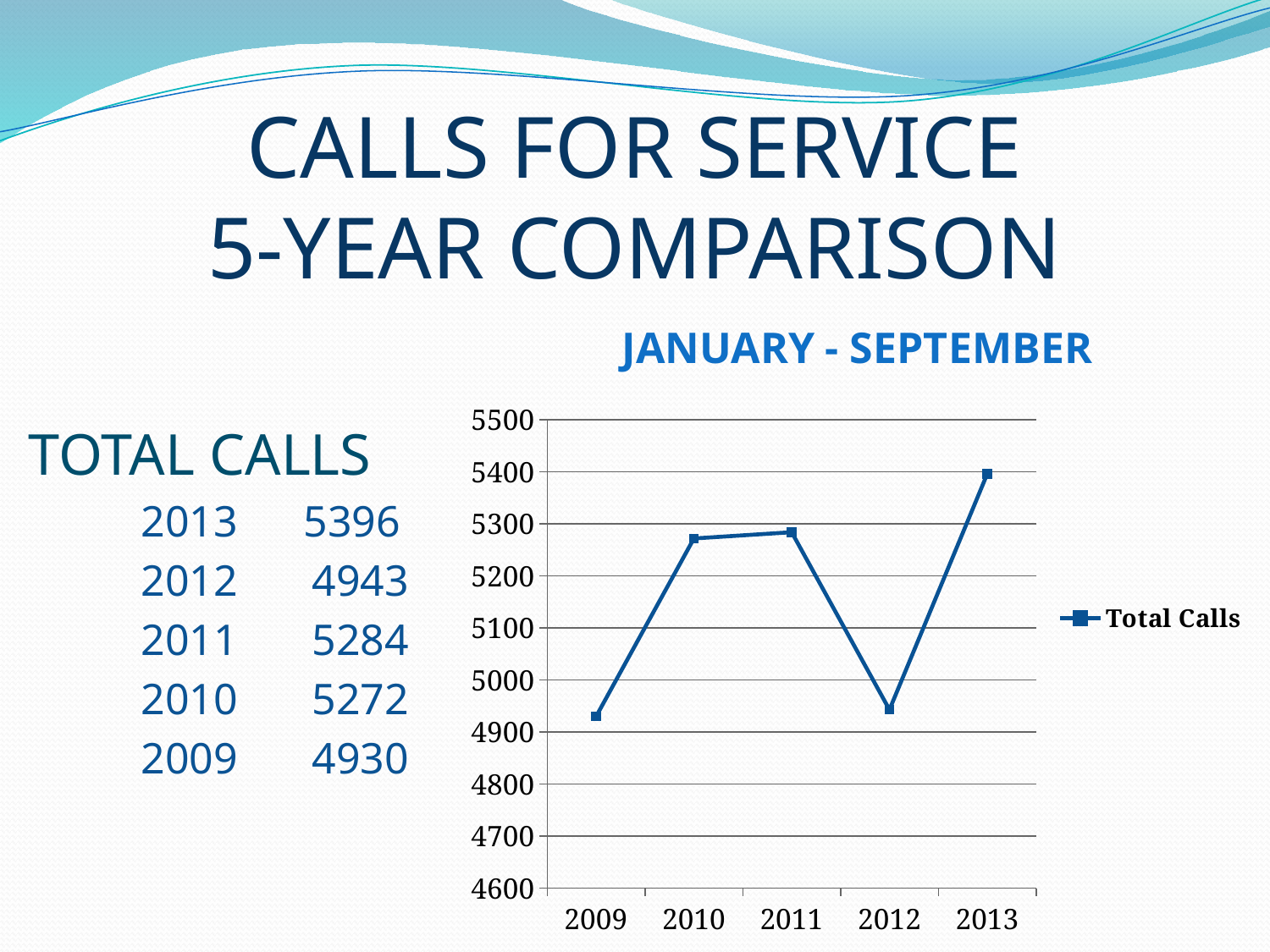
What is the value of Total Calls for 2013? 5396 What is the name of the series shown in the chart legend? Total Calls How many years are plotted on the x axis of the chart? 5 Is the value for 2012 greater or less than 5000? less What is the value of Total Calls for 2009? 4930 What is the difference in Total Calls between 2013 and 2012? 453 How many series does the chart legend list? 1 What kind of chart is shown on the slide? line chart Do Total Calls rise or fall from 2011 to 2012? fall Which year has the highest Total Calls? 2013 Which year has more Total Calls, 2010 or 2012? 2010 Which year has the lowest Total Calls? 2009